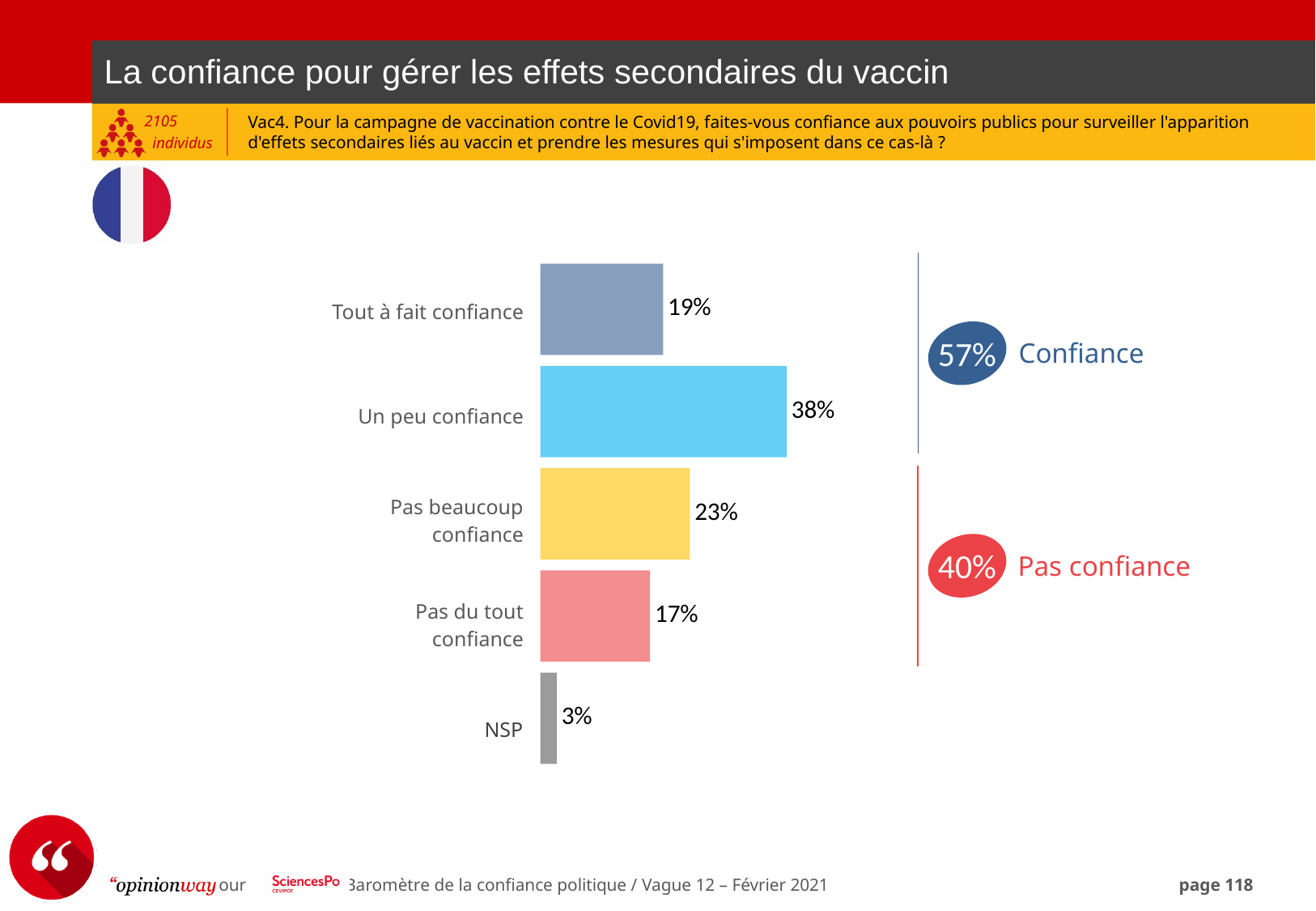
What is the difference between "Un peu confiance" and "Pas beaucoup confiance"? 15% What is the value for "Un peu confiance"? 38% What is the combined "Pas confiance" percentage shown next to the chart? 40% What kind of chart is shown on the slide? Bar chart Which category has the highest value? Un peu confiance What is the value for "Pas du tout confiance"? 17% How many categories are shown in the chart? 5 Which is larger, "Tout à fait confiance" or "Pas du tout confiance"? Tout à fait confiance What is the value for "NSP"? 3% Which category has the lowest value? NSP What is the value for "Tout à fait confiance"? 19% What is the combined "Confiance" percentage shown next to the chart? 57%